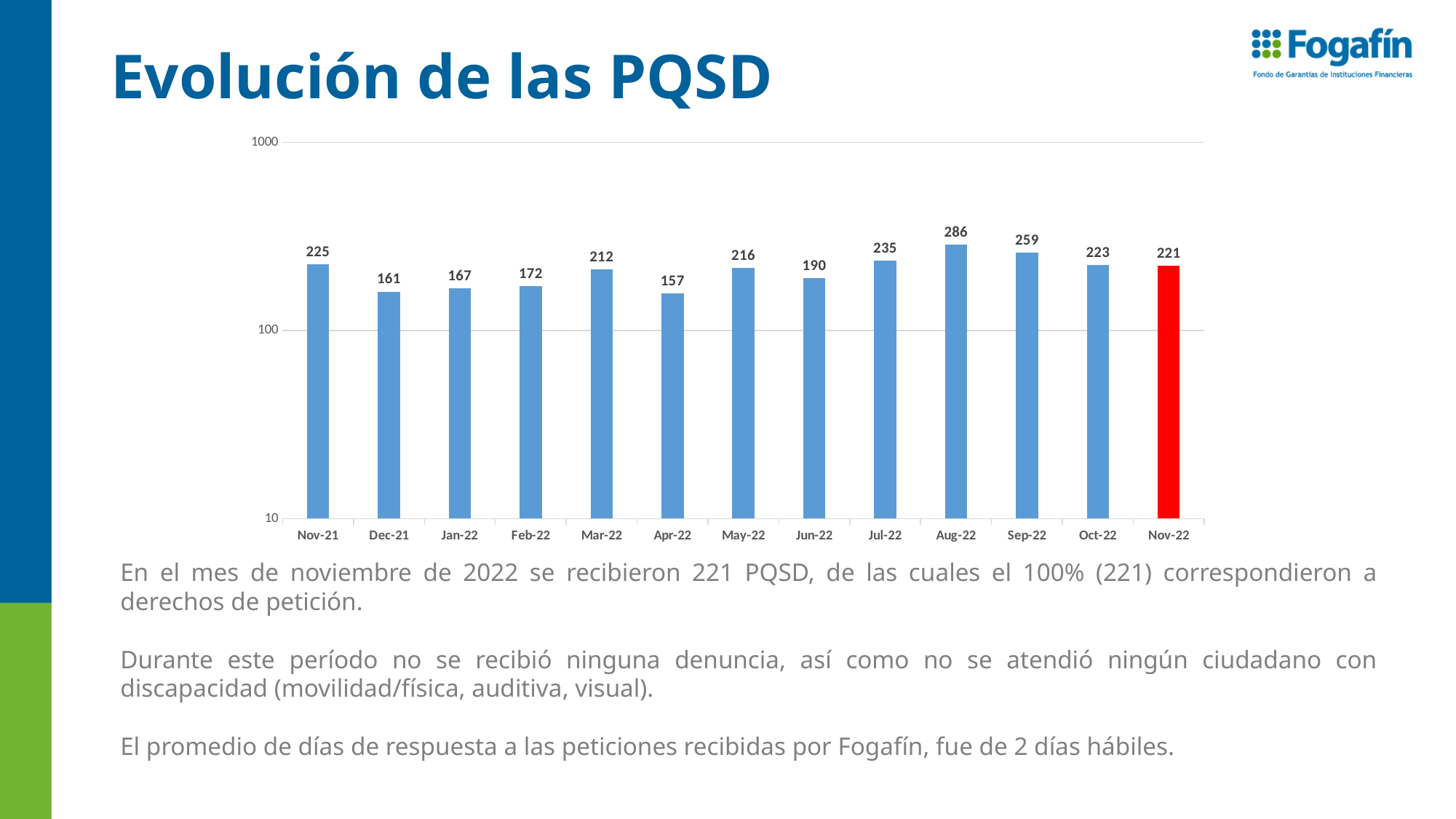
What is the value for Apr-22? 157 What kind of chart is shown on the slide? bar chart Which is larger, the value for Nov-21 or the value for Oct-22? Nov-21 Which bar is coloured red? Nov-22 What is the value for Aug-22? 286 What is the value for Nov-22? 221 Which month has the highest value? Aug-22 Which month has the lowest value? Apr-22 Is the value for Jun-22 greater or less than 100? greater Do the values rise or fall from Apr-22 to Aug-22? rise What is the difference between the values for Aug-22 and Sep-22? 27 How many months are shown on the x axis? 13